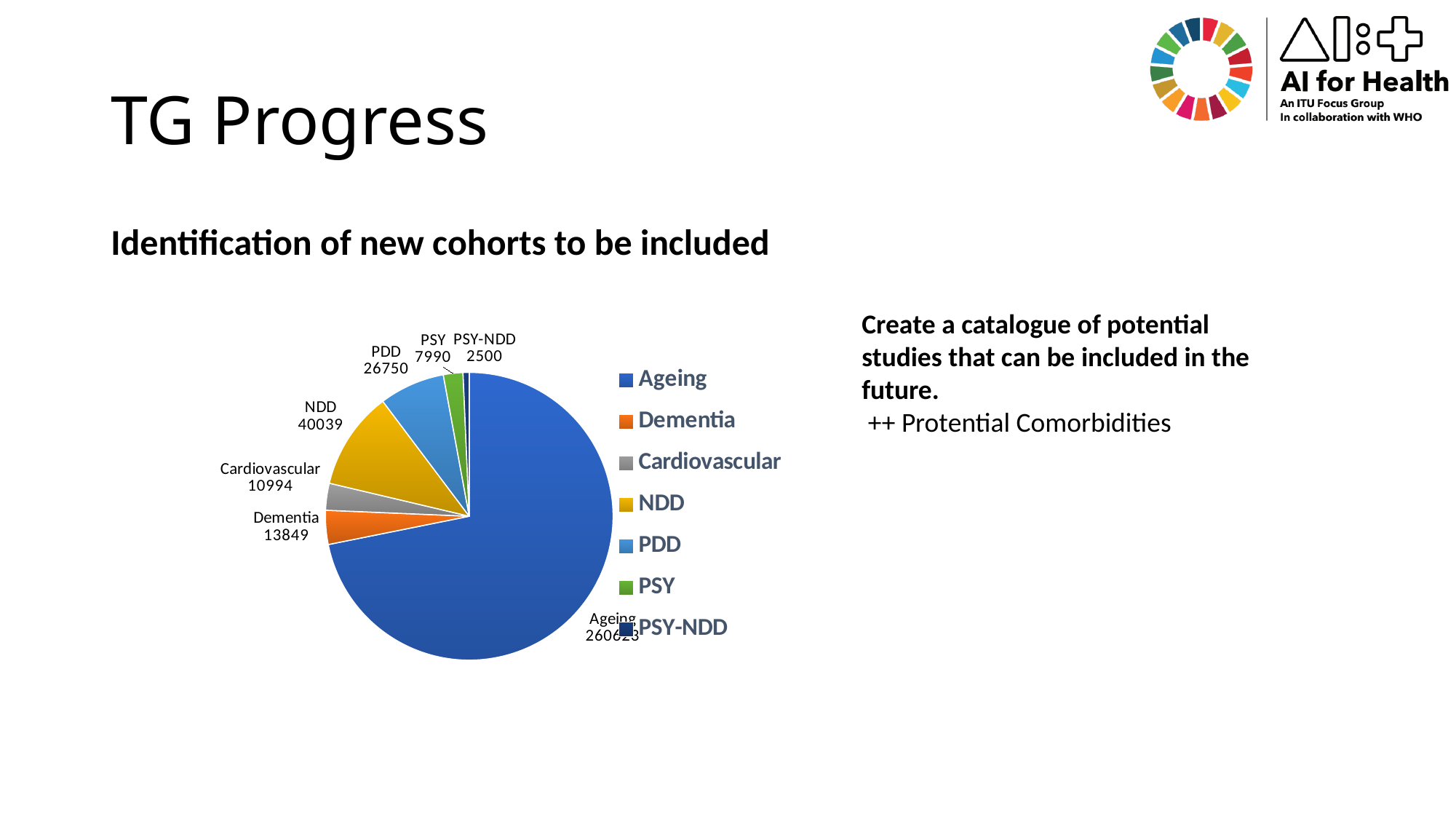
What is the value for Dementia in the pie chart? 13849 What is the value for PDD in the pie chart? 26750 What is the value for Cardiovascular in the pie chart? 10994 What kind of chart is shown on the slide? pie chart Which category has the largest slice of the pie chart? Ageing What is the value for PSY-NDD in the pie chart? 2500 What is the difference between the values for NDD and PDD? 13289 What is the value for NDD in the pie chart? 40039 Which category has the smallest slice of the pie chart? PSY-NDD What colour is the NDD slice in the pie chart? yellow How many categories are shown in the pie chart? 7 Which is larger, the value for Dementia or the value for Cardiovascular? Dementia